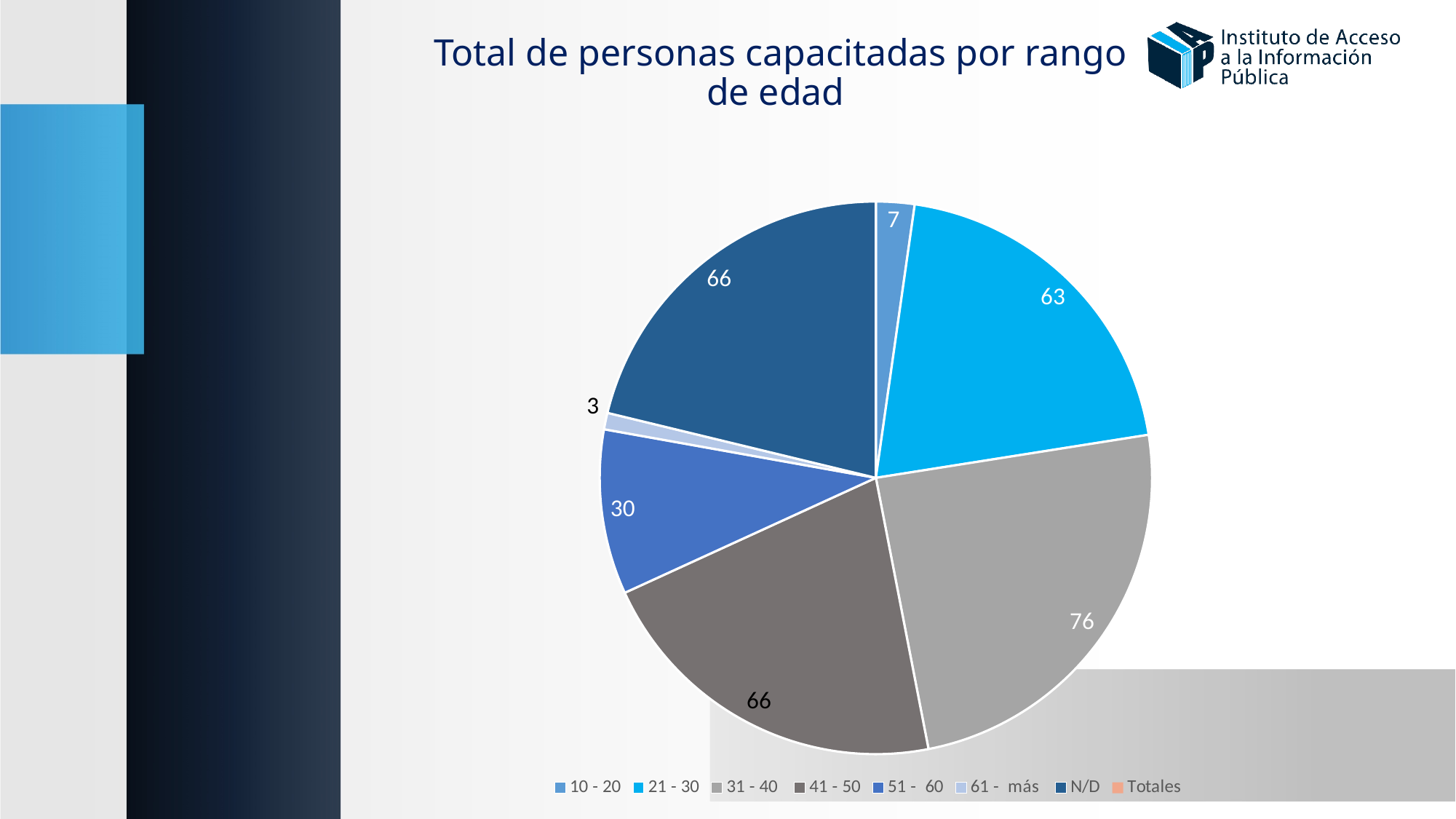
What is the value for the 31 - 40 age range? 76 What is the value for the 21 - 30 age range? 63 What is the difference between the values for 31 - 40 and 21 - 30? 13 What is the value for the N/D category? 66 What is the value for the 10 - 20 age range? 7 Which is larger, the value for 21 - 30 or the value for 51 - 60? 21 - 30 What is the value for the 51 - 60 age range? 30 Which age range has the largest slice of the pie? 31 - 40 Which category has the smallest slice of the pie? 61 - más What is the title of the chart? Total de personas capacitadas por rango de edad What is the difference between the values for 41 - 50 and 51 - 60? 36 What kind of chart is shown on the slide? pie chart